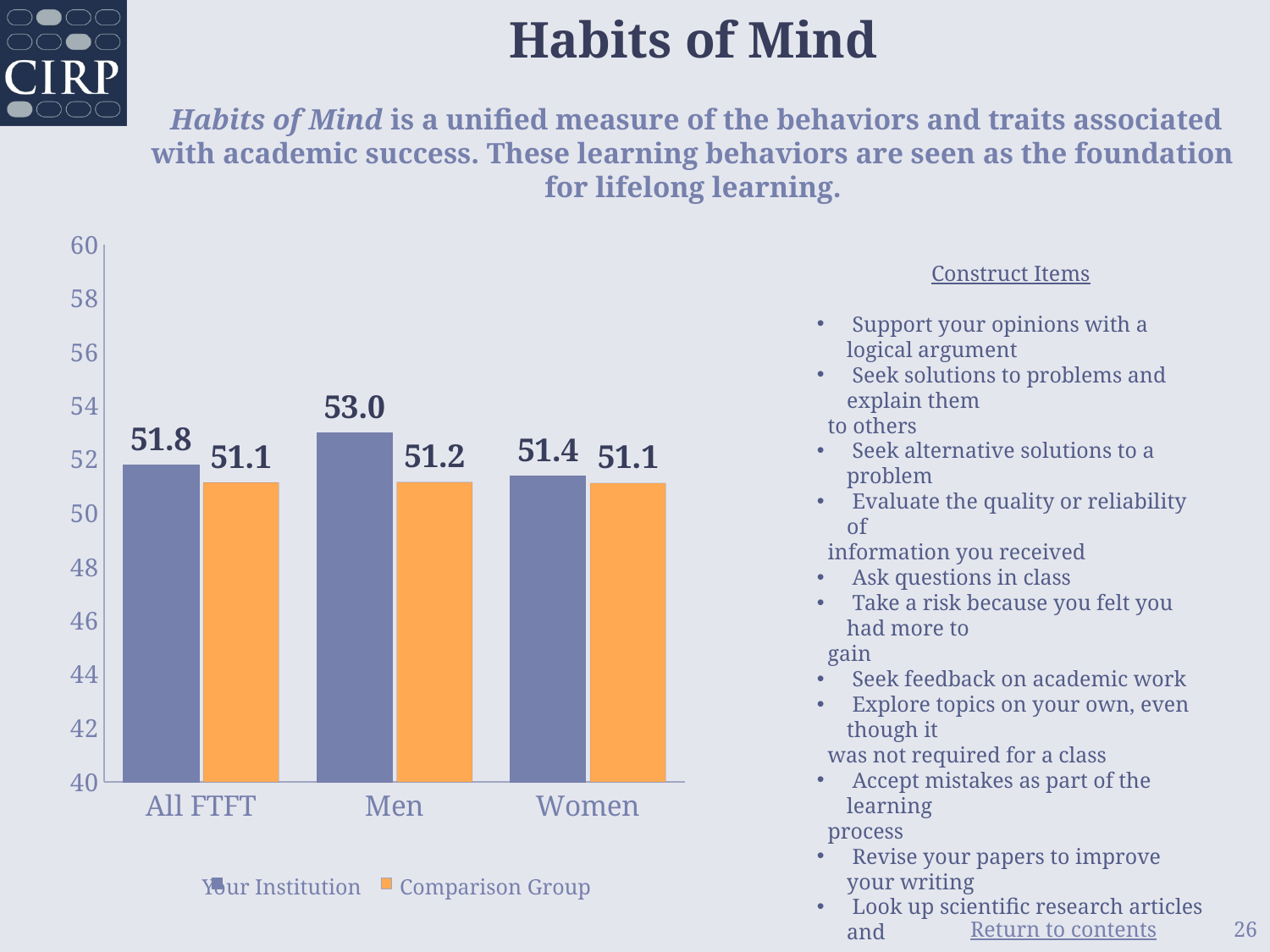
What is the difference between the Your Institution and Comparison Group values for All FTFT? 0.7 What is the difference between the Your Institution and Comparison Group values for Men? 1.8 What is the Comparison Group value for Men? 51.2 How many series does the chart legend list? 2 What is the Comparison Group value for All FTFT? 51.1 What is the Your Institution value for Men? 53.0 For Women, which is larger: the Your Institution value or the Comparison Group value? Your Institution How many categories are shown on the x axis of the chart? 3 What kind of chart is shown on the slide? Bar chart Which category has the highest Your Institution value? Men What is the Your Institution value for Women? 51.4 Which category has the lowest Your Institution value? Women